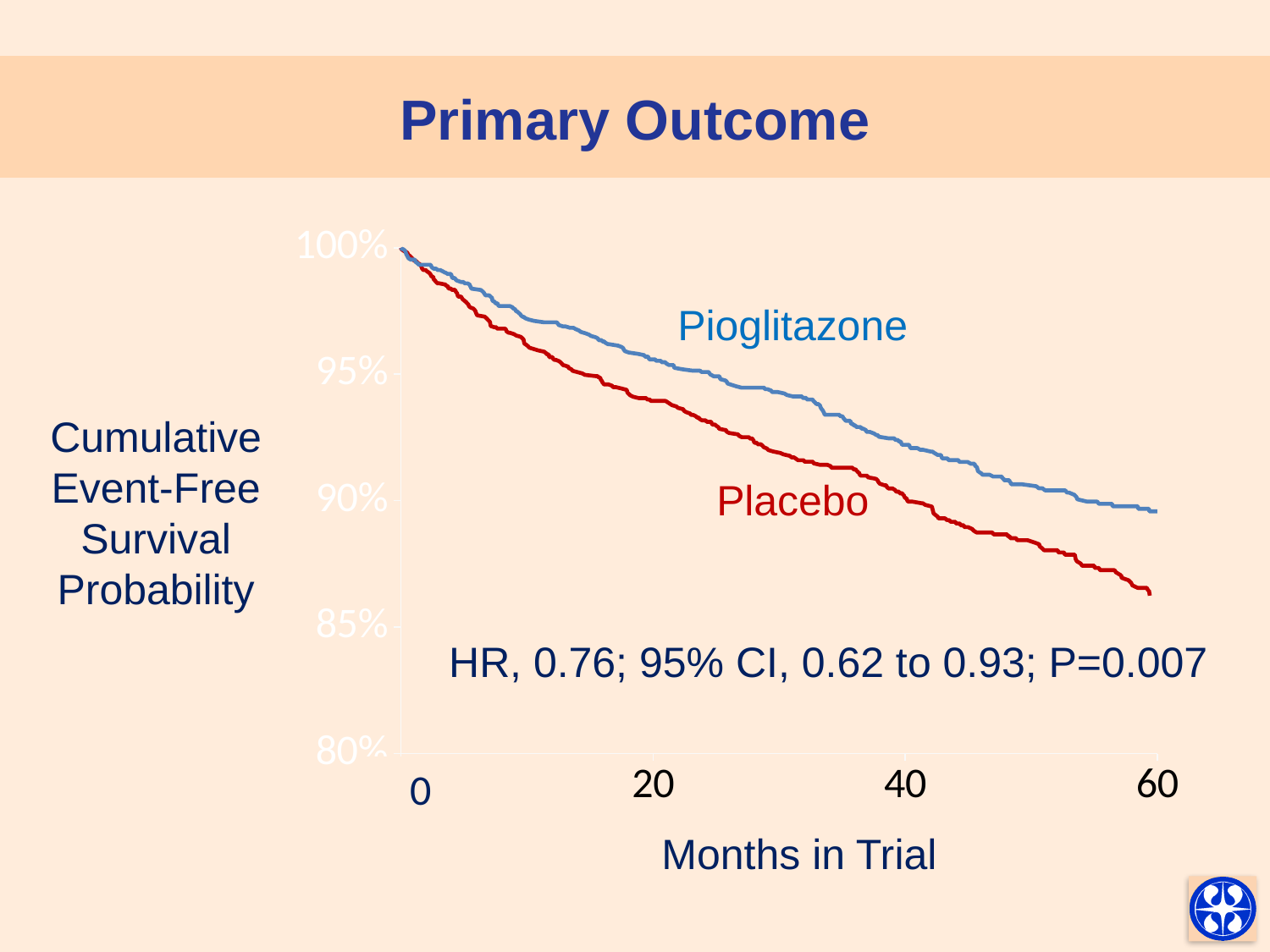
Is the Placebo event-free survival probability at 60 months greater or less than 90%? less At 60 months, which group has the higher event-free survival probability, Pioglitazone or Placebo? Pioglitazone What kind of chart is shown on the slide? line chart What is the hazard ratio reported on the chart? 0.76 Is the Placebo event-free survival probability at 60 months greater or less than 85%? greater Do the survival probability curves rise or fall as months in trial increase? fall How many series are plotted on the chart? 2 What P value is reported on the chart? P=0.007 What is the label of the x axis? Months in Trial Is the Pioglitazone event-free survival probability at 40 months greater or less than 90%? greater Which group has the lower event-free survival probability throughout the trial? Placebo Which two groups are plotted on the chart? Pioglitazone and Placebo